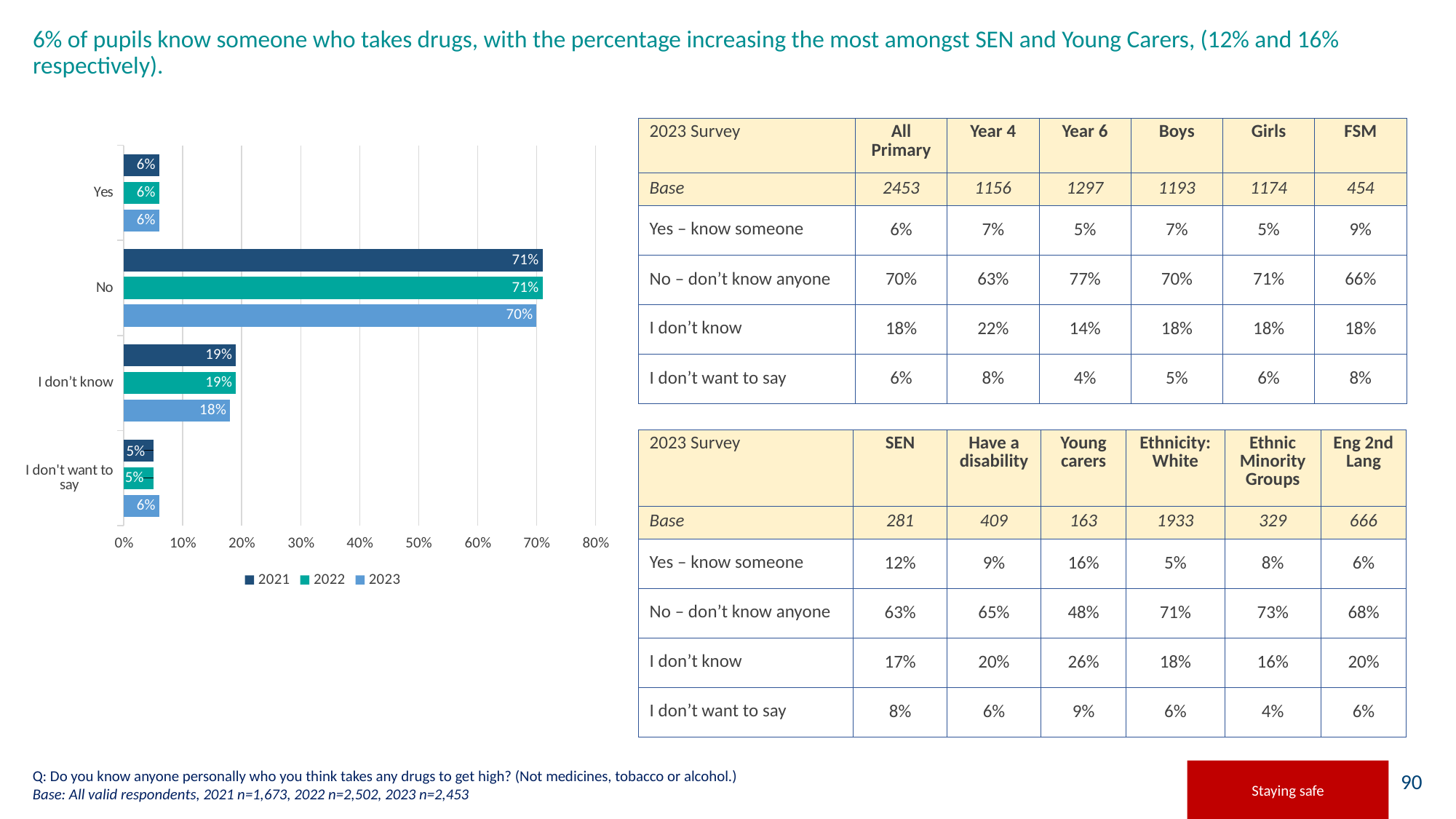
How many series does the chart legend list? 3 What is the 2023 value for 'No' in the chart? 70% What is the difference between the 2021 and 2023 values for 'No' in the chart? 1% What is the 2021 value for 'I don't know' in the chart? 19% How many response categories are shown on the chart? 4 What type of chart is shown on the slide? bar chart Which response category has the highest value for 2023 in the chart? No Which years are listed in the chart legend? 2021, 2022, 2023 Which is larger in the chart: the 2023 value for 'I don't know' or the 2023 value for 'Yes'? I don't know Is the 2022 value for 'No' in the chart greater or less than 60%? greater What is the 2023 value for 'Yes' in the chart? 6% What is the 2022 value for 'I don't want to say' in the chart? 5%